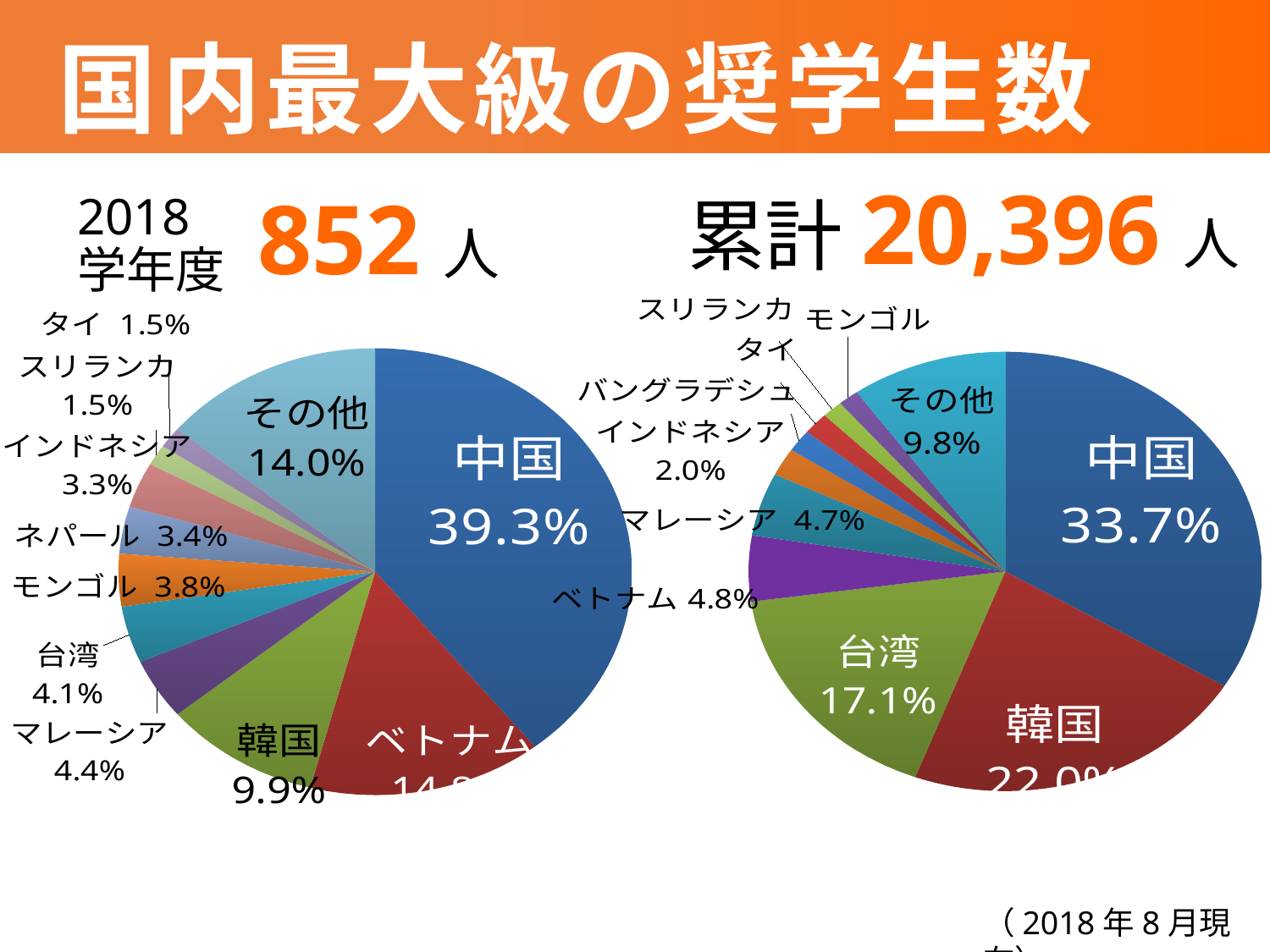
In the left pie chart (2018学年度), what share does 韓国 have? 9.9% In the left pie chart (2018学年度), what is the difference between the shares of 台湾 and モンゴル? 0.3% In the left pie chart (2018学年度), what share does その他 have? 14.0% In the left pie chart (2018学年度), what share does 中国 have? 39.3% In the right pie chart (累計), which is larger, the share of ベトナム or the share of インドネシア? ベトナム In the right pie chart (累計), what share does 中国 have? 33.7% In the right pie chart (累計), what share does 台湾 have? 17.1% In the right pie chart (累計), what share does その他 have? 9.8% What cumulative total number of scholarship students (累計) is shown on the slide? 20,396 人 In the left pie chart (2018学年度), what share does マレーシア have? 4.4% In the left pie chart (2018学年度), which country has the largest share? 中国 What type of chart is used on this slide? Pie chart